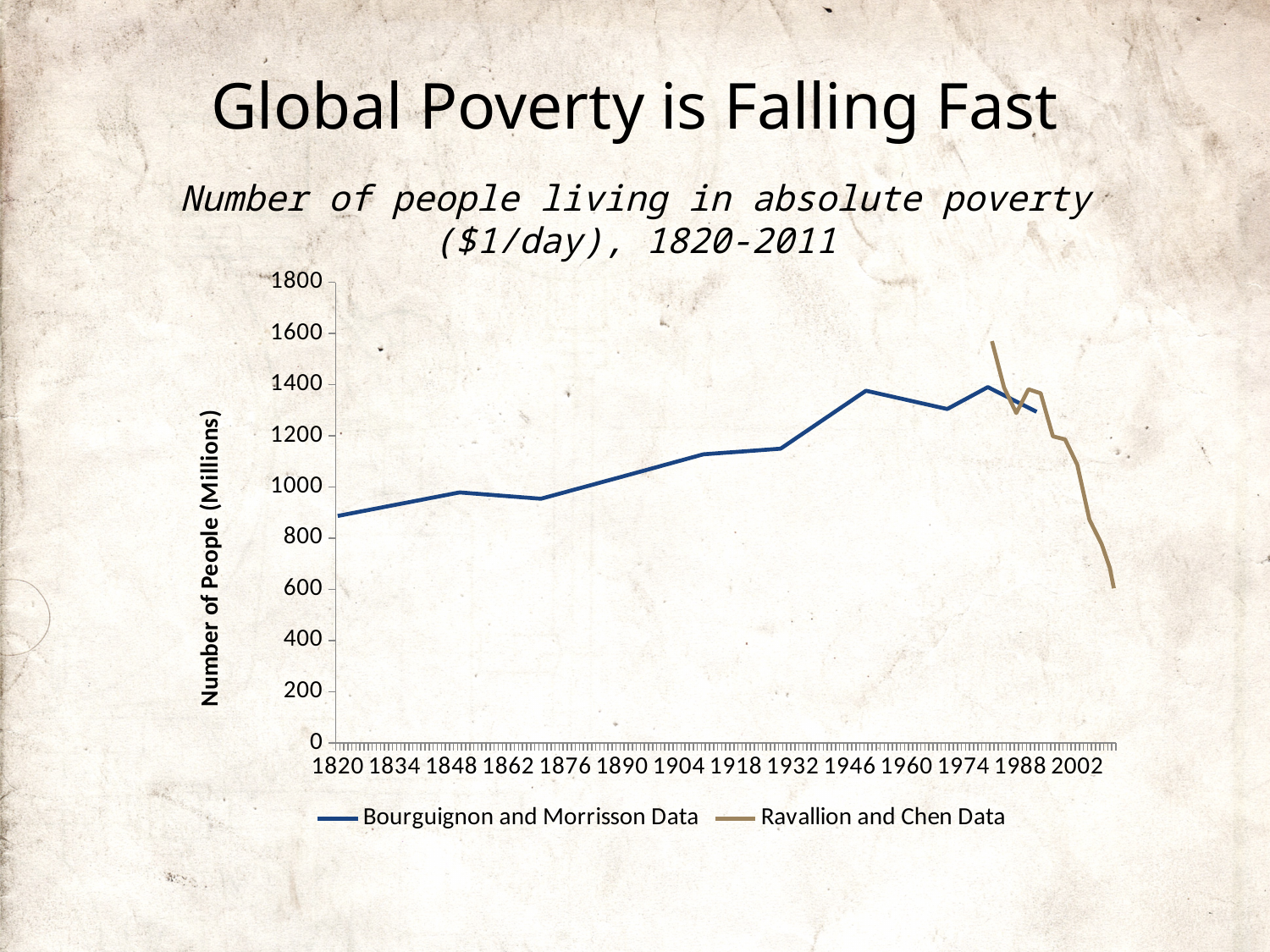
Which series reaches the lowest value on the chart? Ravallion and Chen Data What is the label on the vertical axis? Number of People (Millions) What kind of chart is shown on the slide? line chart Which series reaches the highest value on the chart? Ravallion and Chen Data Does the Bourguignon and Morrisson series rise or fall overall from 1820 to its last point? rise Does the Ravallion and Chen series rise or fall overall along the x axis? fall Is the Bourguignon and Morrisson value for 1820 greater or less than 1000? less How many series does the legend list? 2 What is the title of the chart? Number of people living in absolute poverty ($1/day), 1820-2011 Is the Bourguignon and Morrisson value around 1950 greater or less than 1200? greater Is the Bourguignon and Morrisson value around 1932 greater or less than 1000? greater